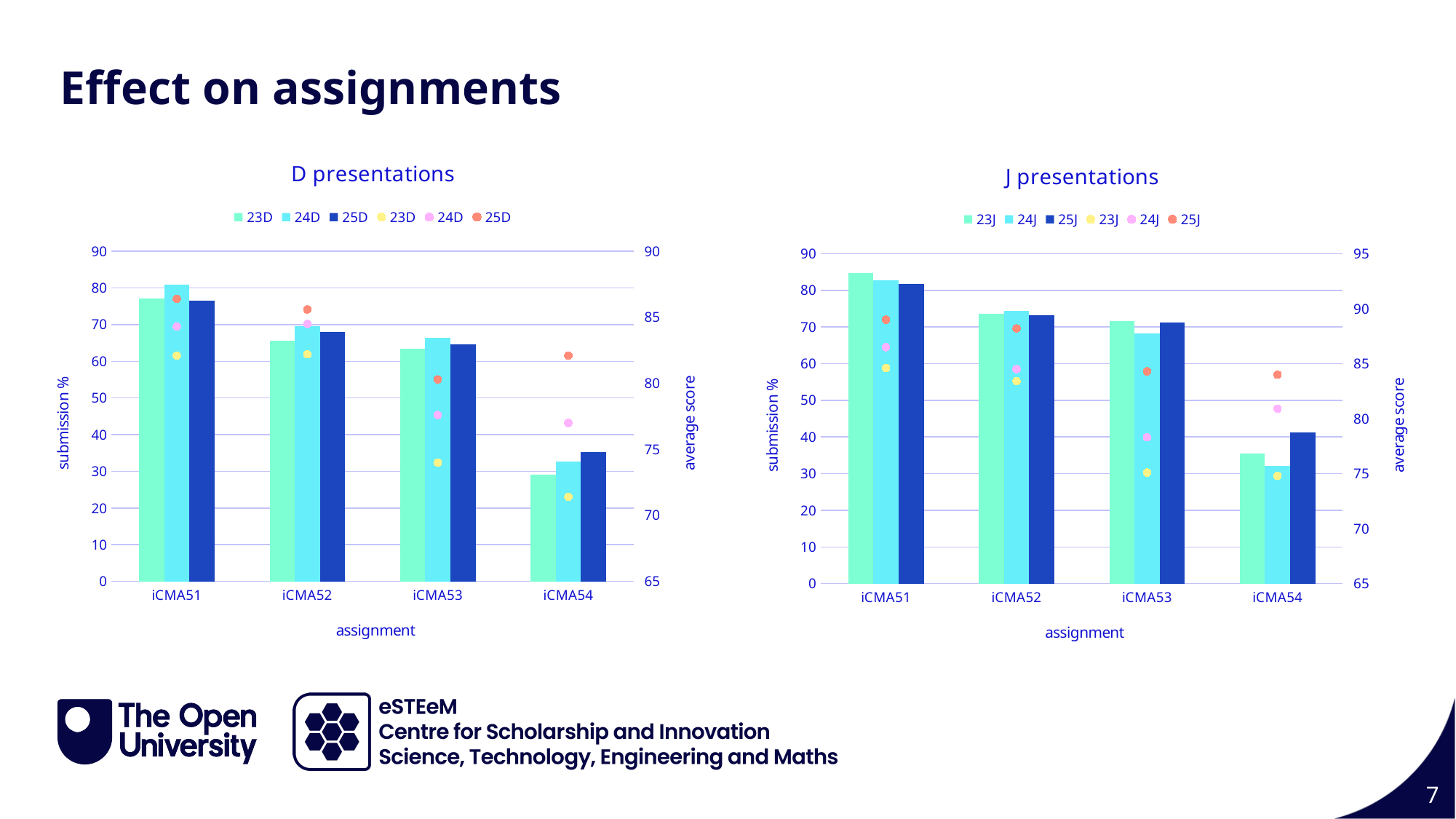
In the J presentations chart, is the 23J submission % bar for iCMA51 greater or less than 80? greater In the D presentations chart, what kind of chart is used to plot the submission % series? bar chart In the J presentations chart, what is the label on the right-hand vertical axis? average score In the D presentations chart, which assignment has the lowest 23D submission %? iCMA54 In the D presentations chart, is the 23D submission % bar for iCMA54 greater or less than 40? less In the D presentations chart, is the 24D submission % bar for iCMA51 greater or less than 80? greater In the J presentations chart, for iCMA54, which submission % bar is larger: 24J or 25J? 25J In the D presentations chart, do the 23D submission % bars rise or fall from iCMA51 to iCMA54? fall In the D presentations chart, how many entries does the legend list? 6 In the D presentations chart, how many assignments are shown on the x axis? 4 In the J presentations chart, which assignment has the highest 25J submission %? iCMA51